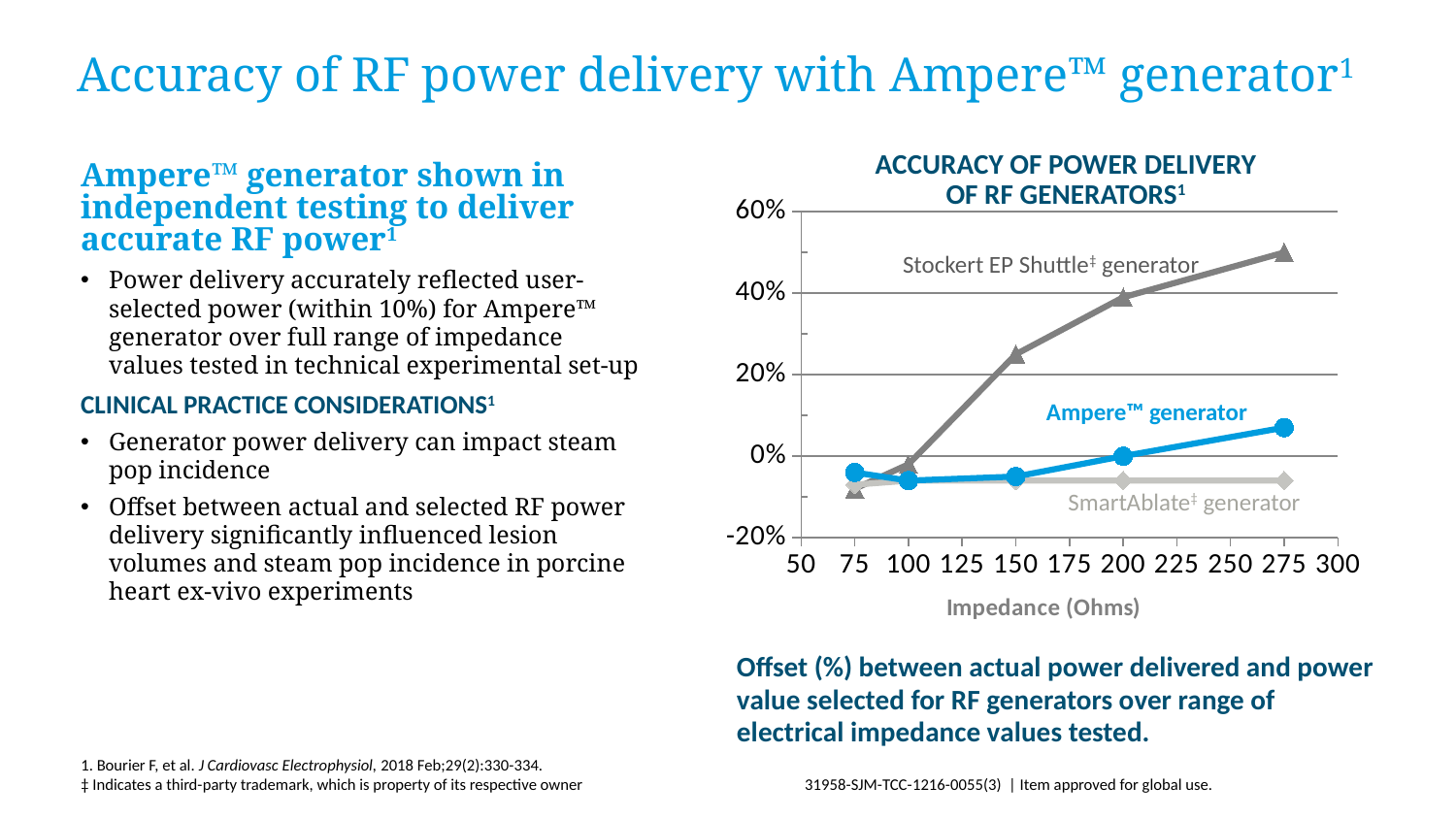
How many generator series are plotted on the chart? 3 At 275 Ohms, which series has the larger value: Stockert EP Shuttle generator or Ampere generator? Stockert EP Shuttle generator How many impedance data points are plotted for the Ampere generator series? 5 Is the value for the SmartAblate generator at 275 Ohms greater or less than 0%? less Does the Stockert EP Shuttle generator series rise or fall as impedance increases from 75 to 275 Ohms? Rises At 275 Ohms, which series has the larger value: Ampere generator or SmartAblate generator? Ampere generator What kind of chart is shown on the slide? Line chart Is the value for the Ampere generator at 275 Ohms greater or less than 20%? less Is the value for the Stockert EP Shuttle generator at 150 Ohms greater or less than 20%? greater What is the title of the chart's x axis? Impedance (Ohms) Which generator series has the highest value at 275 Ohms? Stockert EP Shuttle generator